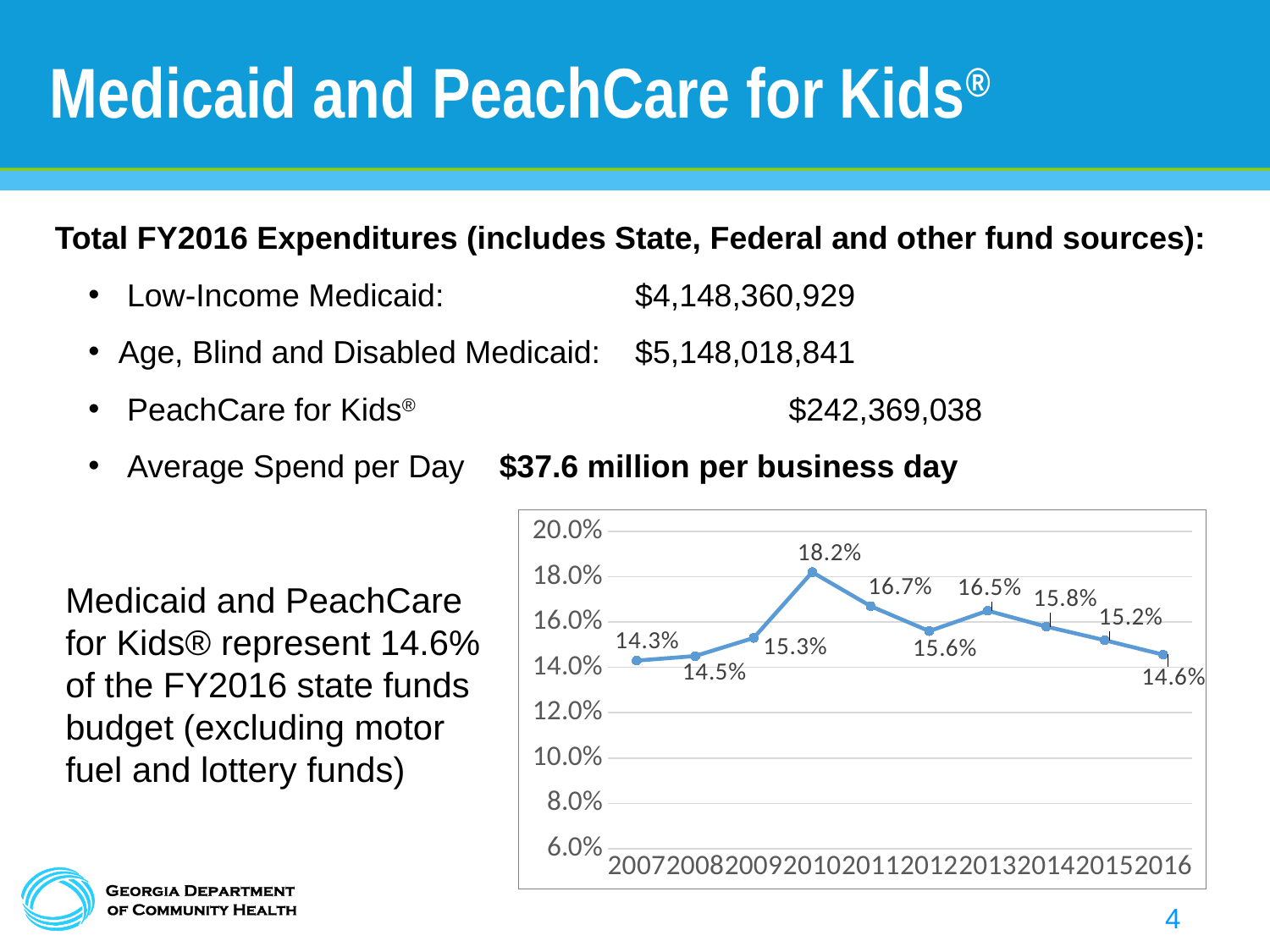
What is the difference between the values for 2010 and 2011 in the line chart? 1.5% What kind of chart is shown on the slide? line chart Is the value for 2010 in the line chart greater or less than 18.0%? greater Which year has the lowest value in the line chart? 2007 What is the value for 2013 in the line chart? 16.5% How many years are plotted in the line chart? 10 What is the value for 2010 in the line chart? 18.2% What is the value for 2016 in the line chart? 14.6% What is the value for 2007 in the line chart? 14.3% Which is larger in the line chart, the value for 2011 or the value for 2013? 2011 Does the value in the line chart rise or fall from 2013 to 2016? fall Which year has the highest value in the line chart? 2010